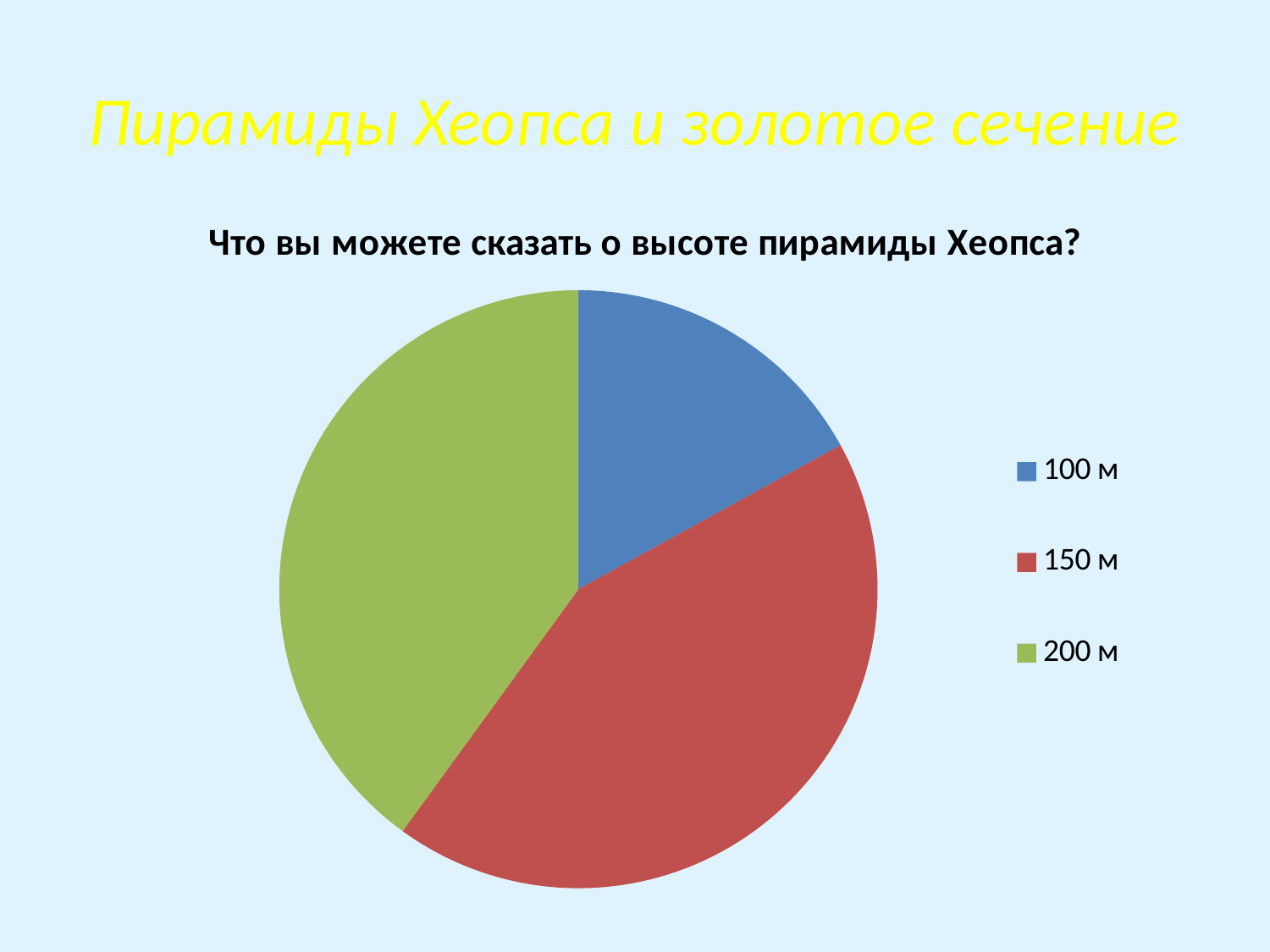
Which slice is larger in the pie chart, 150 м or 100 м? 150 м What is the title of the pie chart? Что вы можете сказать о высоте пирамиды Хеопса? How many slices does the pie chart have? 3 Which slice is larger in the pie chart, 100 м or 200 м? 200 м Which category has the largest slice of the pie chart? 150 м What kind of chart is shown on the slide? pie chart Which category has the smallest slice of the pie chart? 100 м How many entries does the legend of the pie chart list? 3 What colour is the slice for 200 м in the pie chart? green